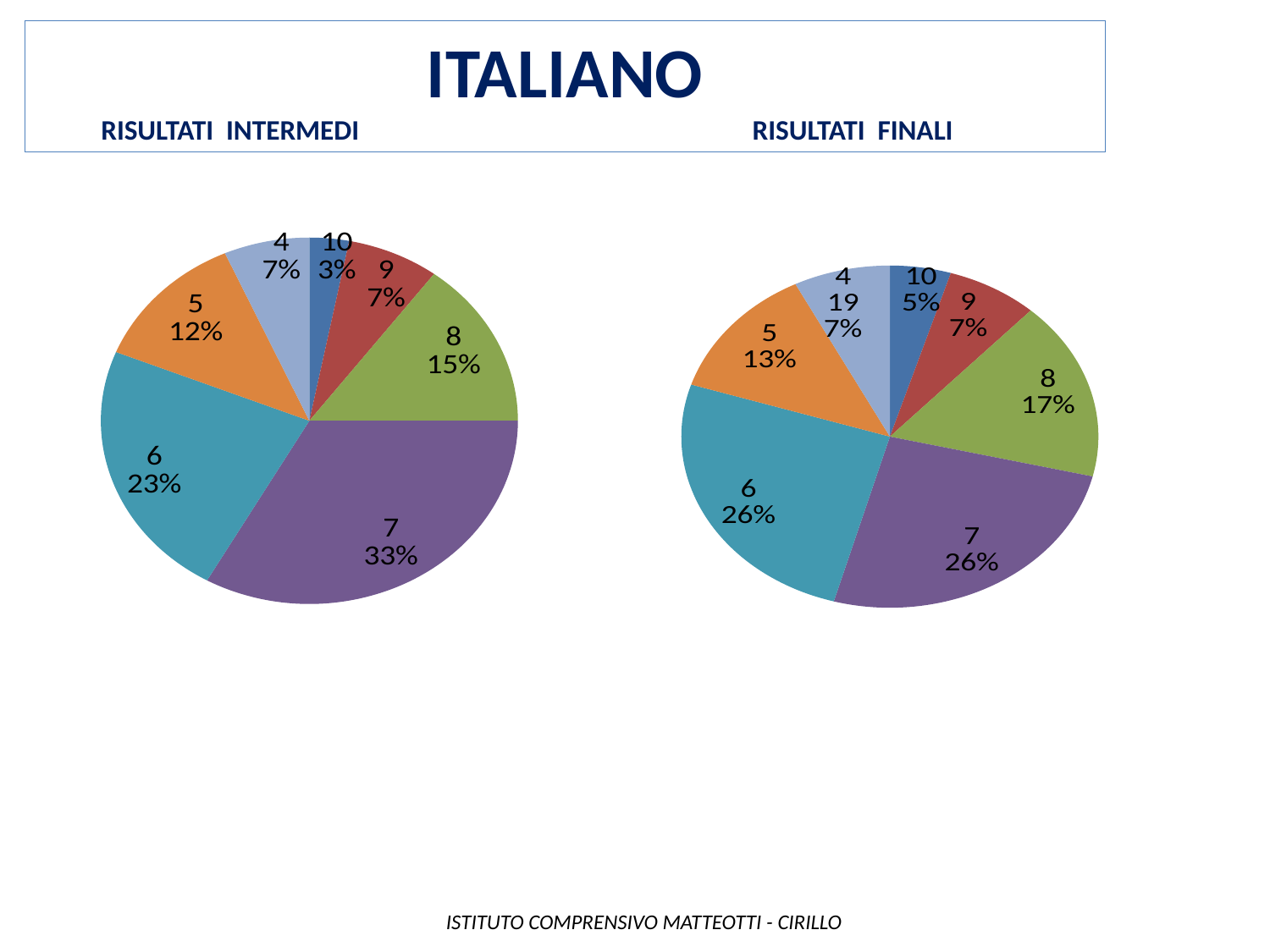
In the RISULTATI INTERMEDI chart, which grade has the largest slice? 7 In the RISULTATI FINALI chart, what share does grade 8 have? 17% What type of chart is used for RISULTATI INTERMEDI? Pie chart In the RISULTATI INTERMEDI chart, which grade has the smallest slice? 10 In the RISULTATI INTERMEDI chart, what is the difference in percentage points between grade 7 and grade 6? 10 In the RISULTATI FINALI chart, what share does grade 10 have? 5% In the RISULTATI INTERMEDI chart, what share does grade 6 have? 23% In the RISULTATI INTERMEDI chart, what share does grade 7 have? 33% In the RISULTATI FINALI chart, which is larger, the slice for grade 8 or the slice for grade 5? 8 How many slices does the RISULTATI FINALI chart have? 7 In the RISULTATI FINALI chart, what share does grade 5 have? 13% What is the title of the slide above the two charts? ITALIANO